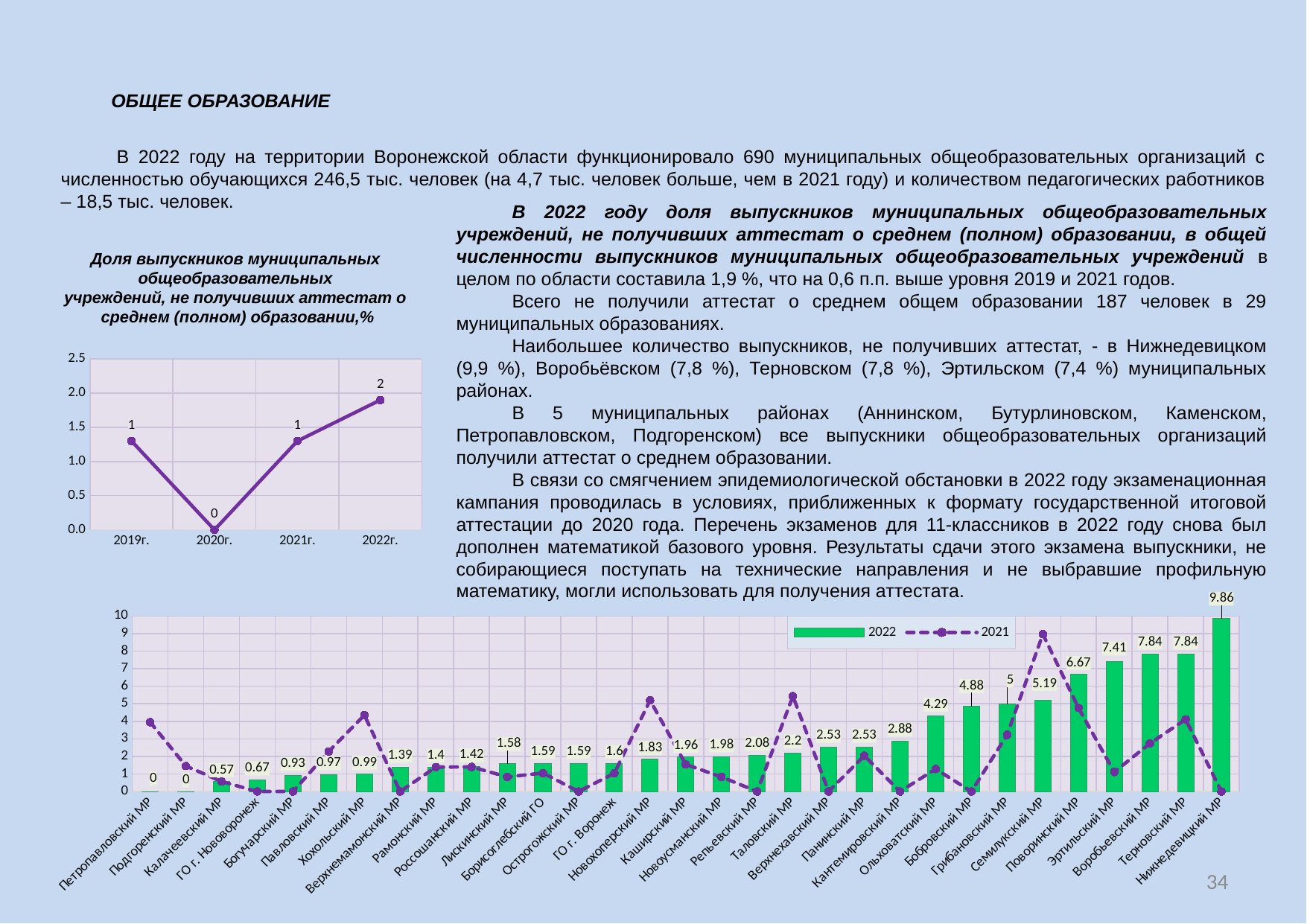
In the bottom bar chart, is the 2021 value for Семилукский МР greater or less than 8? greater In the top-left line chart, which year has the highest value? 2022г. In the top-left line chart, what is the value for 2020г.? 0 In the bottom bar chart, what is the 2022 value for Эртильский МР? 7.41 How many years are plotted in the top-left line chart? 4 In the bottom bar chart, which has the larger 2022 value, Бобровский МР or Семилукский МР? Семилукский МР How many series does the legend of the bottom bar chart list? 2 In the bottom bar chart, which category has the highest 2022 value? Нижнедевицкий МР In the bottom bar chart, what is the 2022 value for Ольховатский МР? 4.29 In the bottom bar chart, what is the 2022 value for Нижнедевицкий МР? 9.86 What kind of chart is the chart in the top-left of the slide? line chart In the bottom bar chart, what is the difference between the 2022 values for Нижнедевицкий МР and Поворинский МР? 4.67